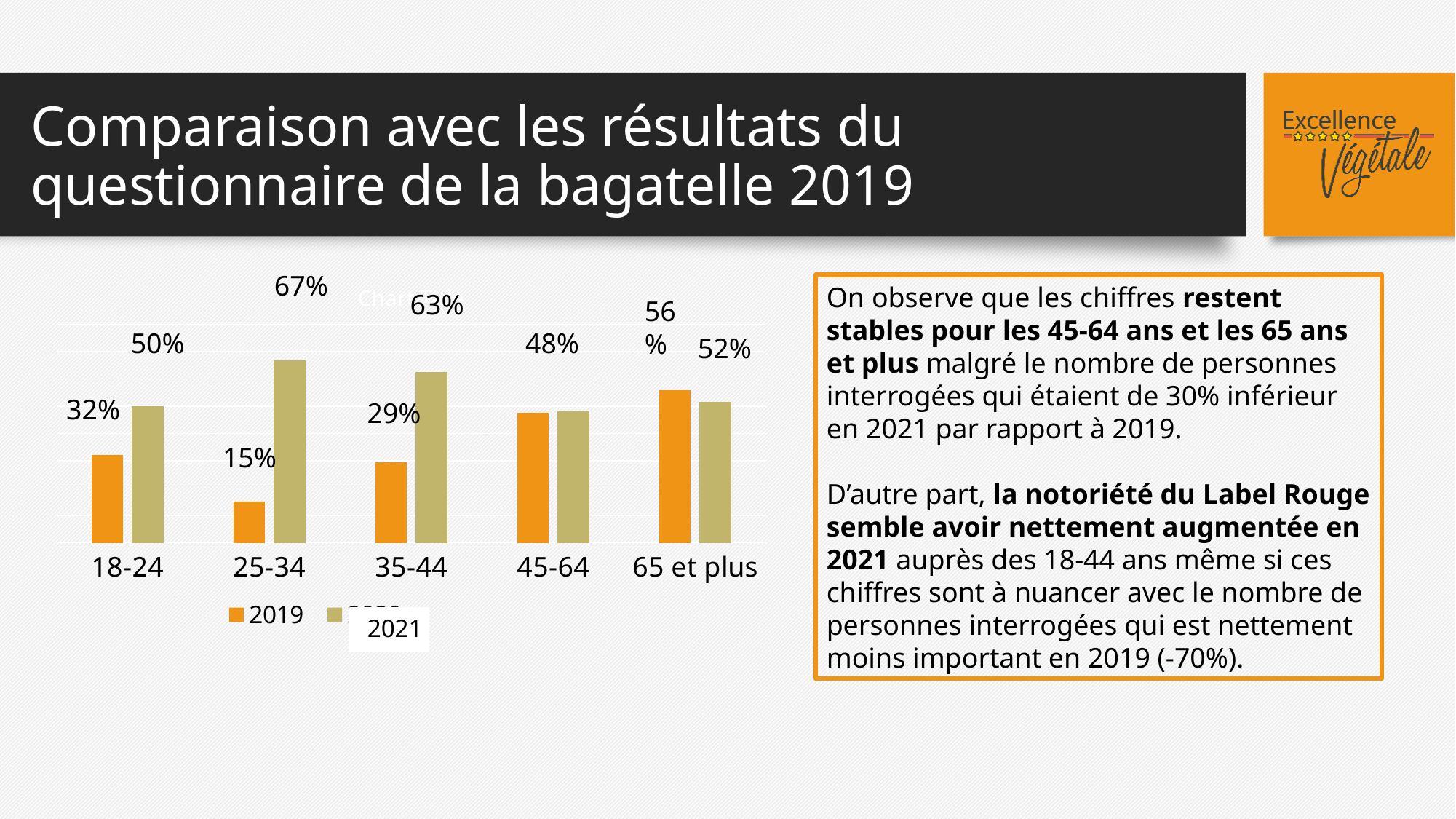
What is the 2021 value for the 65 et plus age group? 52% Which age group has the highest 2021 value? 25-34 What is the 2019 value for the 18-24 age group? 32% For the 65 et plus age group, which is larger: the 2019 value or the 2021 value? 2019 What kind of chart is shown on the slide? Bar chart Which age group has the lowest 2019 value? 25-34 What is the 2021 value for the 25-34 age group? 67% How many series does the legend list? 2 What is the 2019 value for the 65 et plus age group? 56% What is the 2019 value for the 35-44 age group? 29% How many age groups are shown on the x axis? 5 What is the difference between the 2021 and 2019 values for the 25-34 age group? 52 percentage points